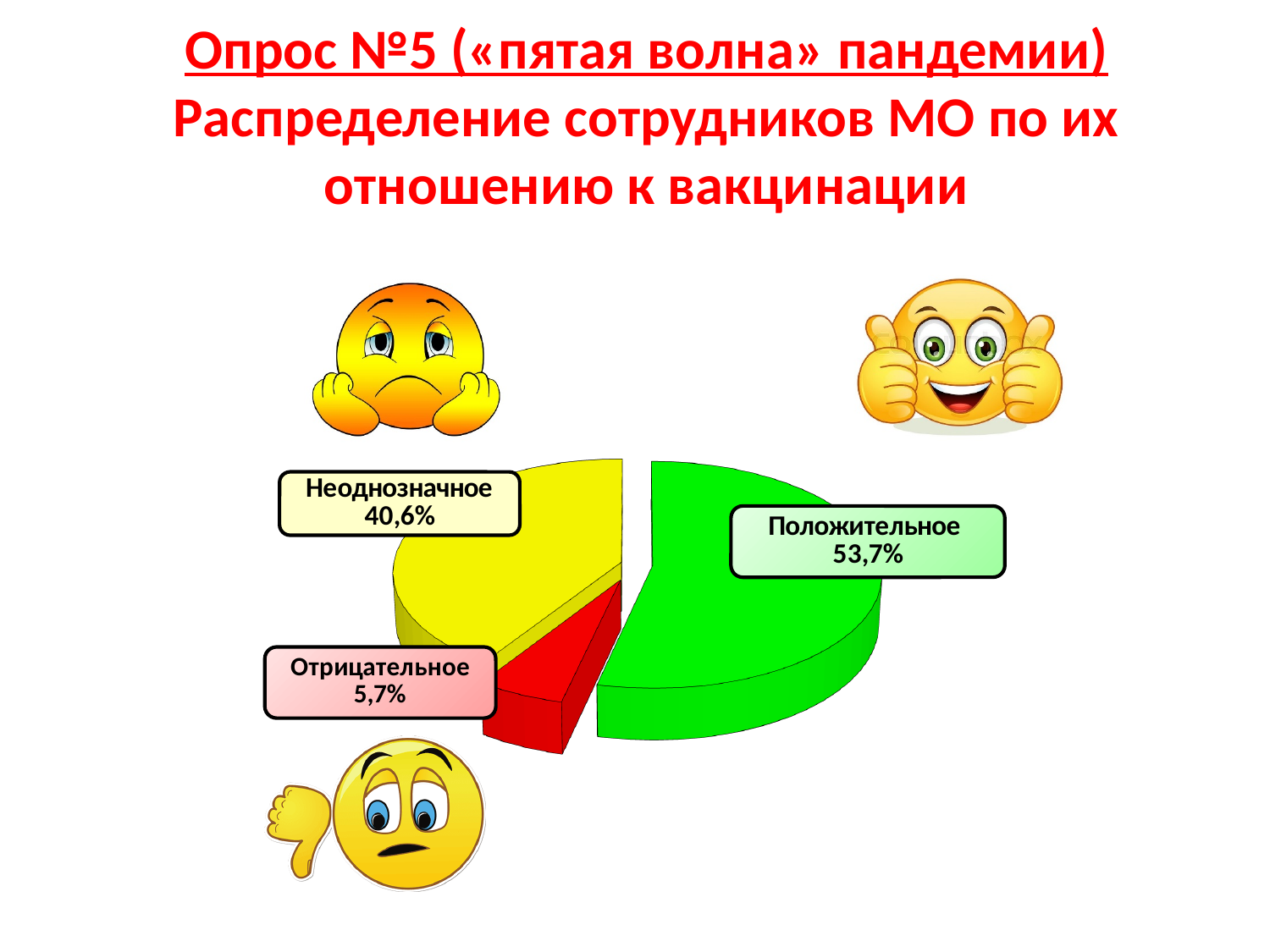
What kind of chart is shown on the slide? Pie chart What is the difference between the "Неоднозначное" and "Отрицательное" values? 34,9% What colour is the "Отрицательное" slice? Red Which category has the smallest slice of the pie? Отрицательное What share of the pie does the "Положительное" slice represent? 53,7% What colour is the "Положительное" slice? Green Which is larger, the "Неоднозначное" slice or the "Отрицательное" slice? Неоднозначное Which category has the largest slice of the pie? Положительное What is the difference between the "Положительное" and "Неоднозначное" values? 13,1% How many slices does the pie chart have? 3 What is the value shown for "Отрицательное"? 5,7% What is the value shown for "Неоднозначное"? 40,6%